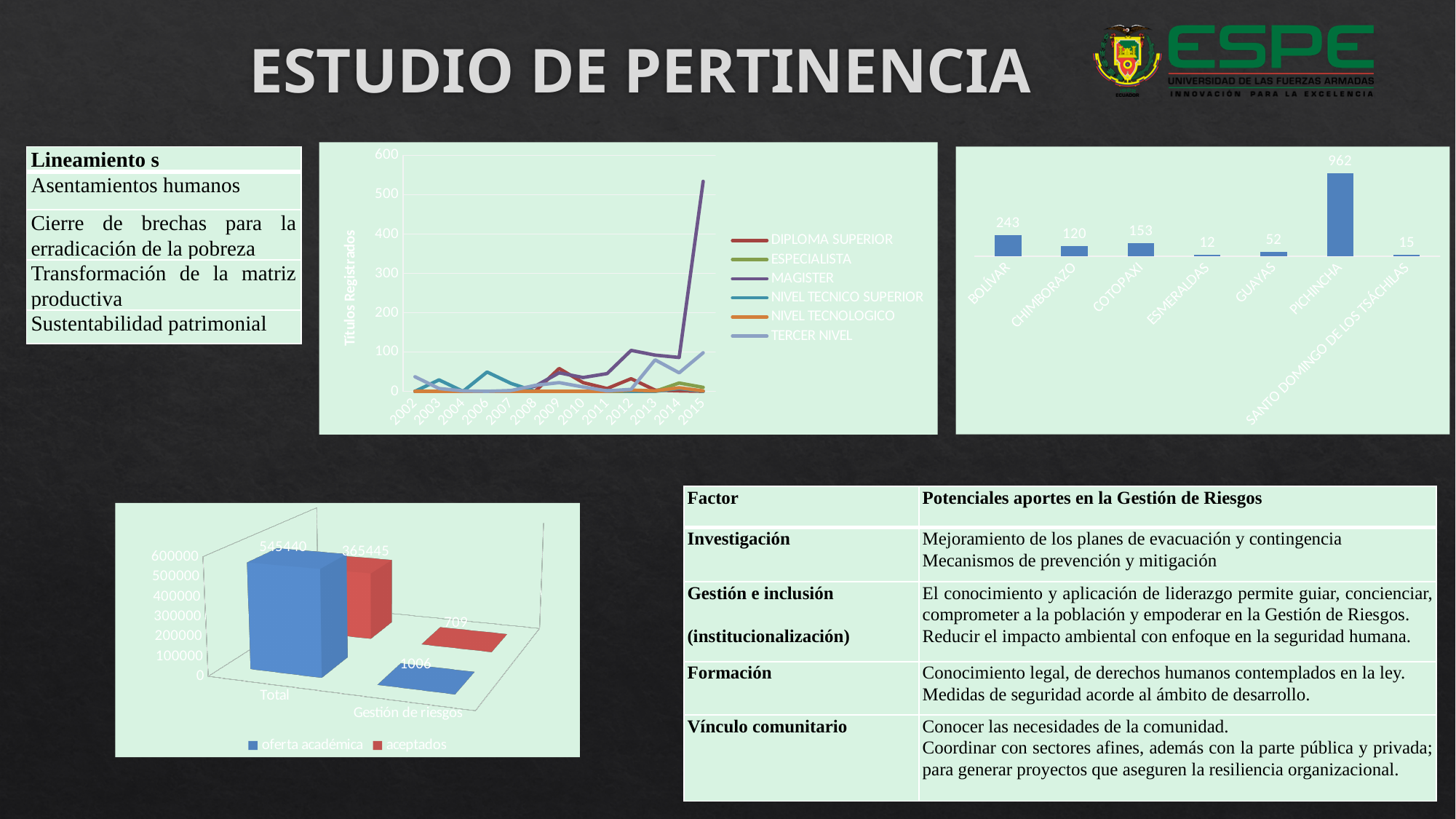
How many provinces are shown in the top-right bar chart? 7 In the top-right bar chart, which province has the highest value? PICHINCHA In the top-right bar chart, what is the value for PICHINCHA? 962 How many series does the legend of the top-middle line chart list? 6 In the bottom-left chart, what is the value of oferta académica for Total? 545440 In the top-right bar chart, which province has the lowest value? ESMERALDAS In the top-middle line chart, is the MAGISTER value for 2015 greater or less than 400? greater In the top-right bar chart, what is the value for BOLÍVAR? 243 What type of chart is the top-middle chart with the years 2002 to 2015 on the x axis? line chart In the bottom-left chart, what is the value of aceptados for Gestión de riesgos? 709 In the top-right bar chart, which is larger, the value for GUAYAS or the value for SANTO DOMINGO DE LOS TSÁCHILAS? GUAYAS In the top-right bar chart, what is the difference between the values for COTOPAXI and CHIMBORAZO? 33